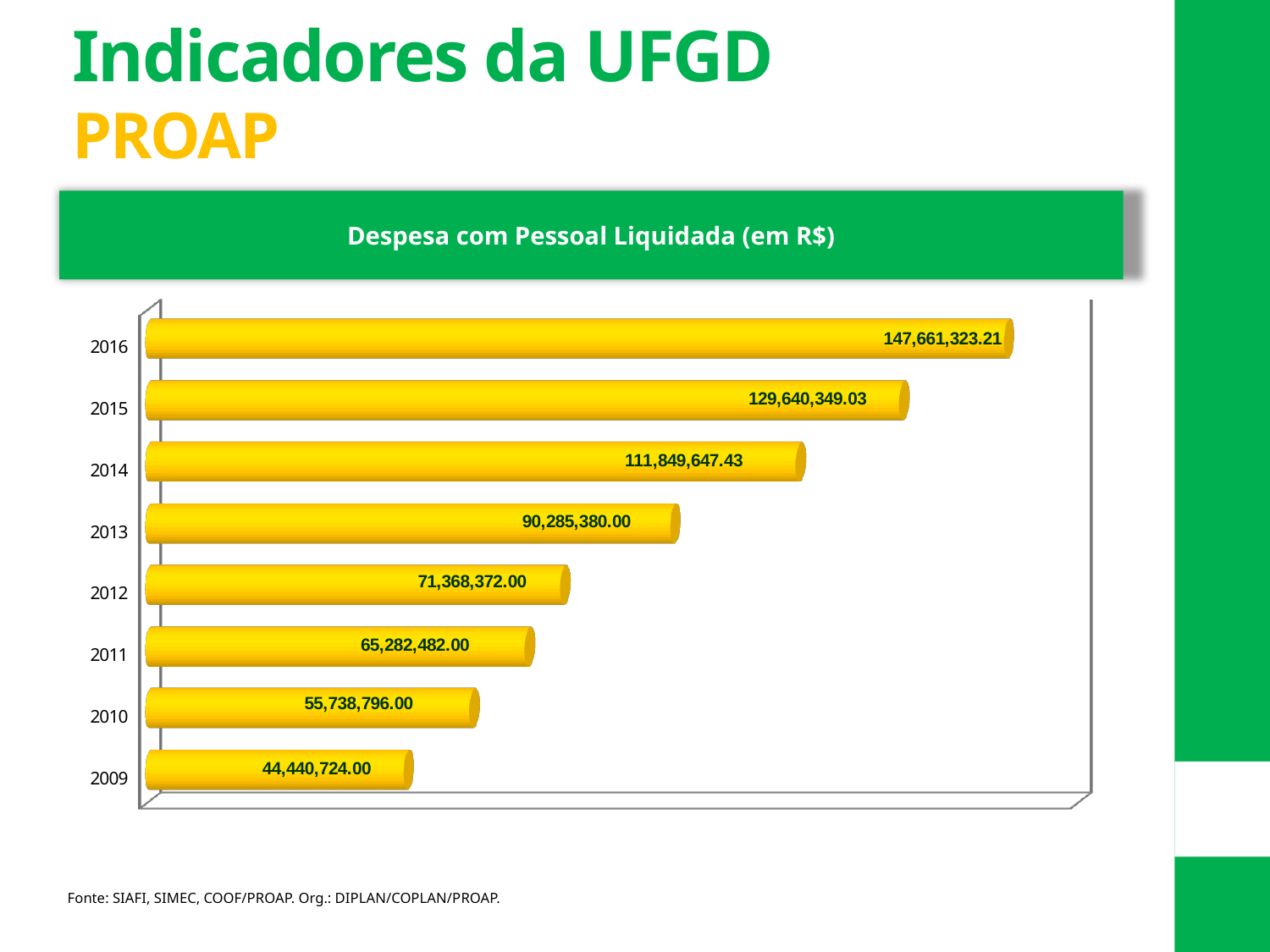
What is the value for 2011 in the Despesa com Pessoal Liquidada chart? 65,282,482.00 What is the value for 2013 in the Despesa com Pessoal Liquidada chart? 90,285,380.00 What kind of chart is used to show Despesa com Pessoal Liquidada? Bar chart What is the difference between the values for 2016 and 2015 in the Despesa com Pessoal Liquidada chart? 18,020,974.18 Which year has the highest Despesa com Pessoal Liquidada? 2016 Which year has the lowest Despesa com Pessoal Liquidada? 2009 Which year has a larger Despesa com Pessoal Liquidada, 2012 or 2014? 2014 What is the value for 2009 in the Despesa com Pessoal Liquidada chart? 44,440,724.00 What is the value for 2016 in the Despesa com Pessoal Liquidada chart? 147,661,323.21 How many years are shown in the Despesa com Pessoal Liquidada chart? 8 Do the Despesa com Pessoal Liquidada values rise or fall from 2009 to 2016? Rise What is the difference between the values for 2010 and 2009 in the Despesa com Pessoal Liquidada chart? 11,298,072.00